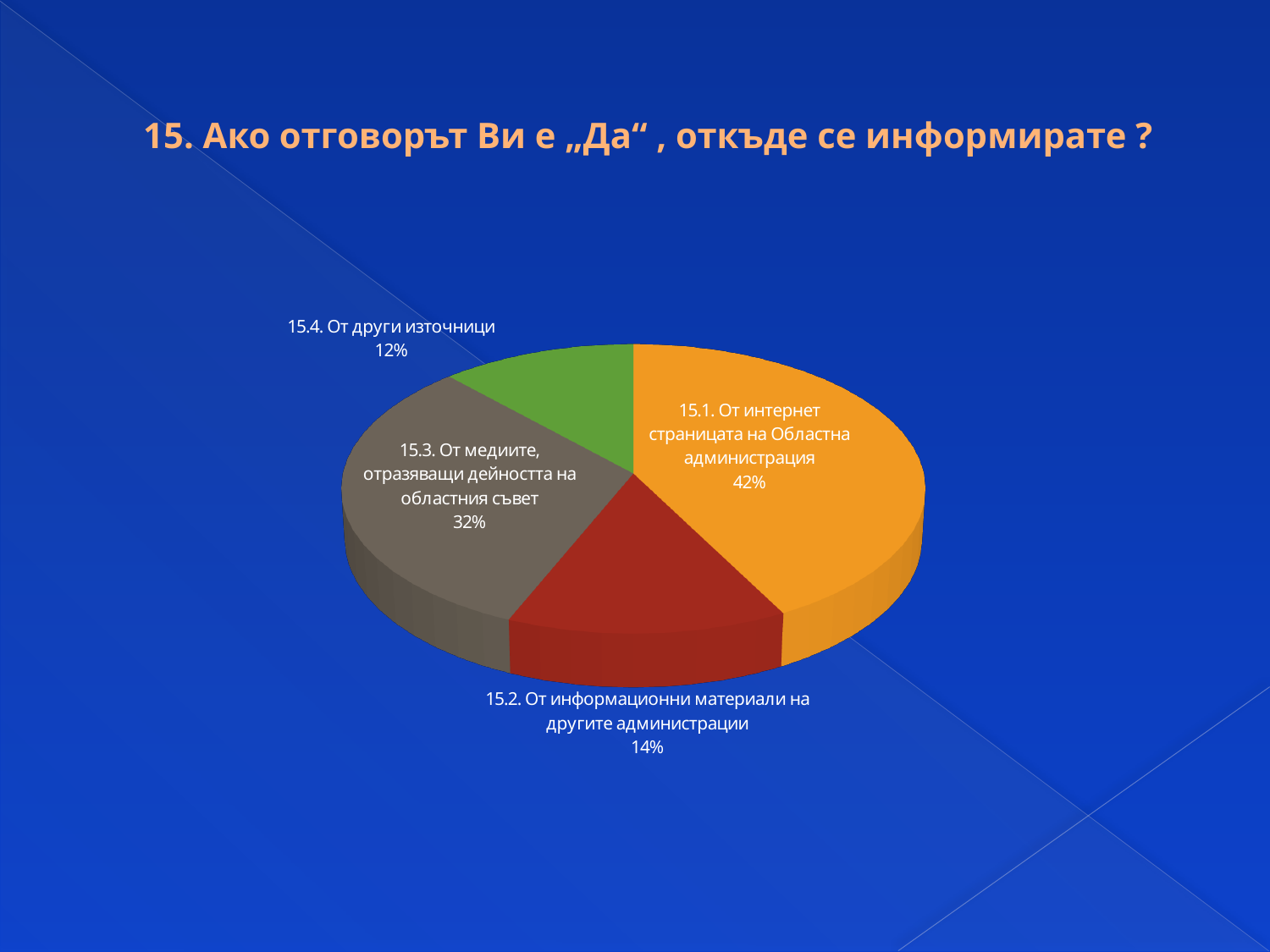
What is the difference in percentage points between "15.1. От интернет страницата на Областна администрация" and "15.3. От медиите, отразяващи дейността на областния съвет"? 10 How many slices does the pie chart have? 4 What share does "15.4. От други източници" have? 12% What is the combined share of "15.3. От медиите, отразяващи дейността на областния съвет" and "15.4. От други източници"? 44% Which category has the smallest share of the pie? 15.4. От други източници What share does "15.2. От информационни материали на другите администрации" have? 14% What kind of chart is shown on the slide? pie chart What share does "15.1. От интернет страницата на Областна администрация" have? 42% What colour is the slice for "15.4. От други източници"? green Which is larger: the share for "15.2. От информационни материали на другите администрации" or for "15.4. От други източници"? 15.2. От информационни материали на другите администрации What share does "15.3. От медиите, отразяващи дейността на областния съвет" have? 32% Which category has the largest share of the pie? 15.1. От интернет страницата на Областна администрация